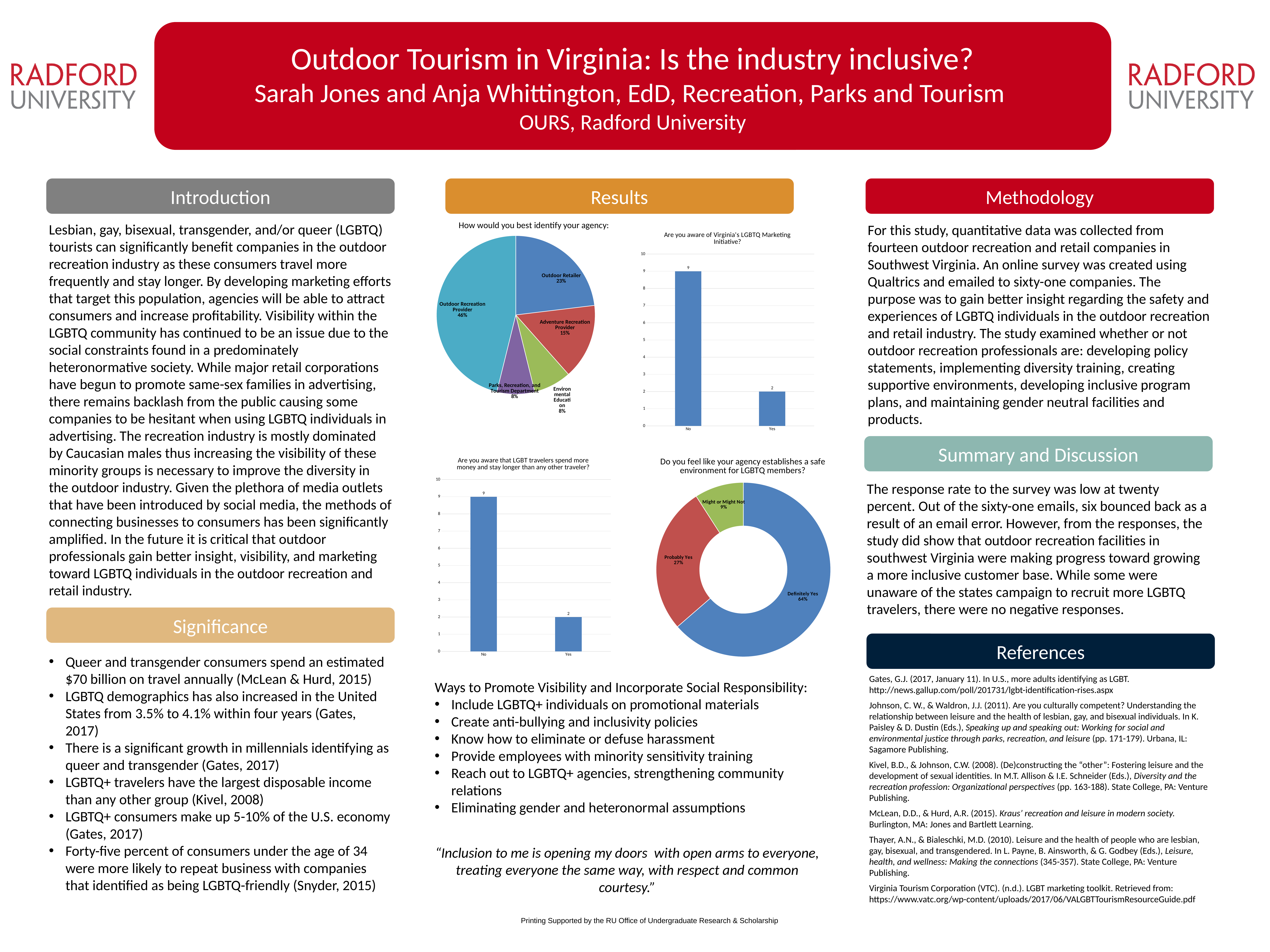
In the pie chart 'How would you best identify your agency', how many categories are shown? 5 In the pie chart 'How would you best identify your agency', what is the difference between the Outdoor Retailer and Adventure Recreation Provider shares? 8% In the pie chart 'How would you best identify your agency', which category has the largest share? Outdoor Recreation Provider In the chart 'Are you aware of Virginia's LGBTQ Marketing Initiative?', what is the value for Yes? 2 In the pie chart 'How would you best identify your agency', what share is Outdoor Retailer? 23% In the pie chart 'How would you best identify your agency', what share is Outdoor Recreation Provider? 46% In the chart 'Do you feel like your agency establishes a safe environment for LGBTQ members?', which category has the smallest share? Might or Might Not In the chart 'Are you aware that LGBT travelers spend more money and stay longer than any other traveler?', what is the difference between No and Yes? 7 In the chart 'Are you aware that LGBT travelers spend more money and stay longer than any other traveler?', which category is higher, No or Yes? No In the chart 'Do you feel like your agency establishes a safe environment for LGBTQ members?', what share is Definitely Yes? 64% What kind of chart is 'Are you aware of Virginia's LGBTQ Marketing Initiative?'? bar chart In the chart 'Are you aware of Virginia's LGBTQ Marketing Initiative?', what is the value for No? 9